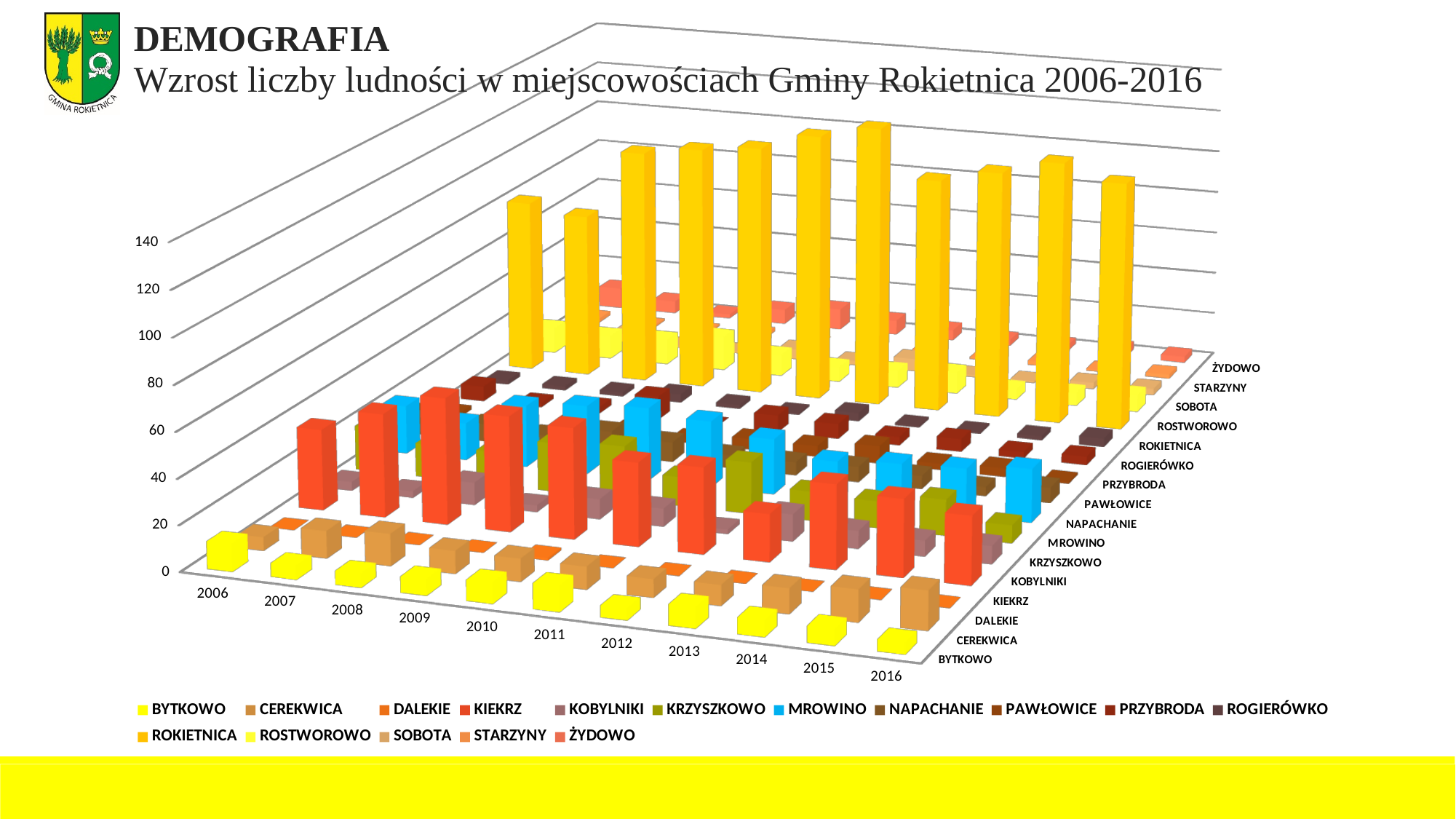
What is the first year shown on the x axis of the chart? 2006 How many series (villages) does the chart legend list? 16 What is the last year shown on the x axis of the chart? 2016 Which village has the highest population bars in the chart? ROKIETNICA How many years are shown along the x axis of the chart? 11 Which village is listed first in the chart legend? BYTKOWO What kind of chart is shown on the slide? bar chart